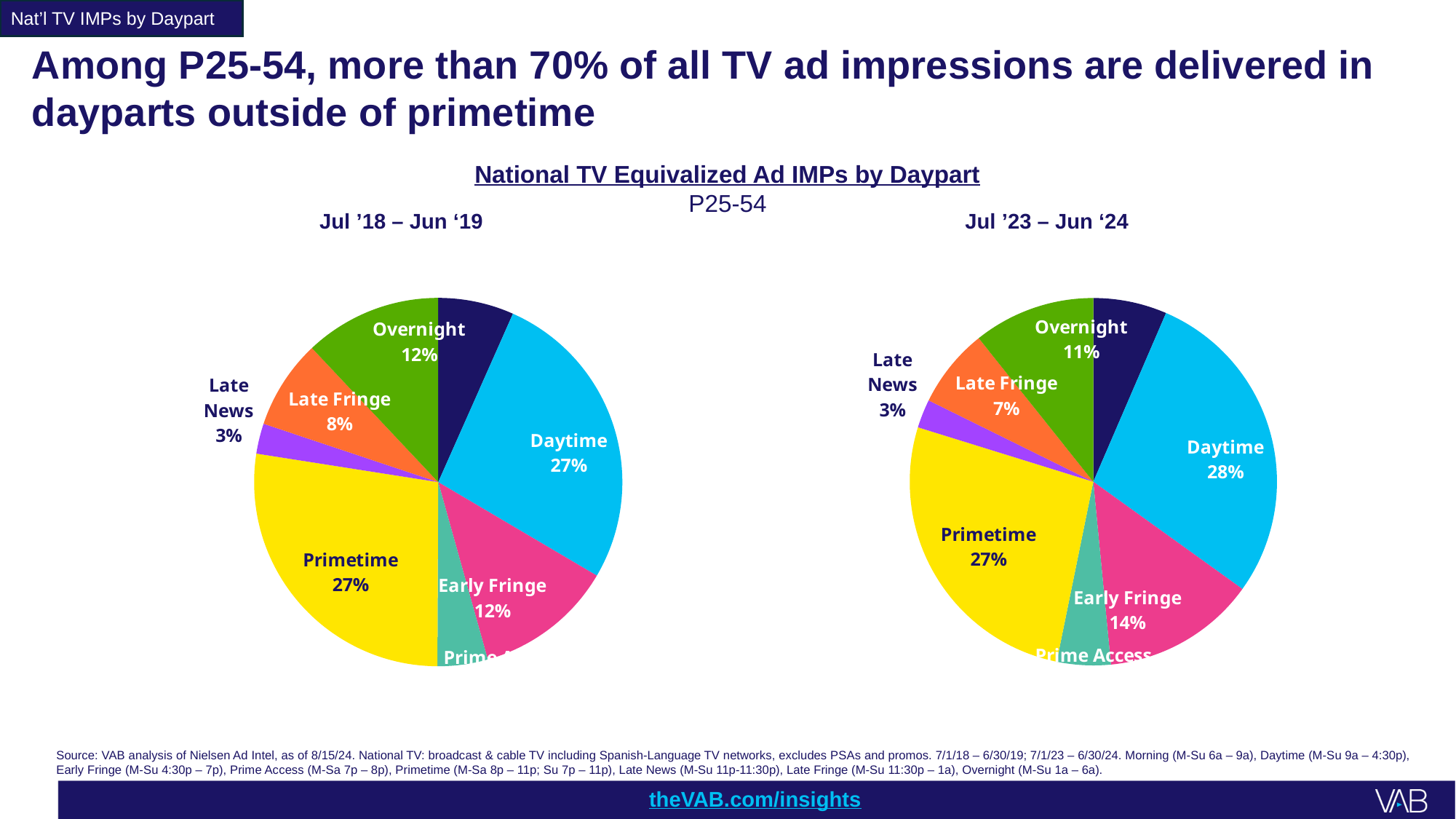
Comparing the two pie charts, is the Early Fringe share larger in Jul '18 – Jun '19 or in Jul '23 – Jun '24? Jul '23 – Jun '24 In the Jul '23 – Jun '24 pie chart, which labeled daypart has the largest share? Daytime In the Jul '23 – Jun '24 pie chart, what share of ad impressions is Early Fringe? 14% In the Jul '18 – Jun '19 pie chart, which labeled daypart has the smallest share? Late News What kind of charts are shown on the slide? Pie charts In the Jul '18 – Jun '19 pie chart, which is larger, Early Fringe or Late Fringe? Early Fringe In the Jul '23 – Jun '24 pie chart, what is the difference in percentage points between Daytime and Late News? 25 In the Jul '23 – Jun '24 pie chart, what share is Overnight? 11% In the Jul '18 – Jun '19 pie chart, what share is Late Fringe? 8% What is the title shown above the two pie charts? National TV Equivalized Ad IMPs by Daypart How many slices does the Jul '23 – Jun '24 pie chart have? 8 In the Jul '18 – Jun '19 pie chart, what share of ad impressions is Daytime? 27%